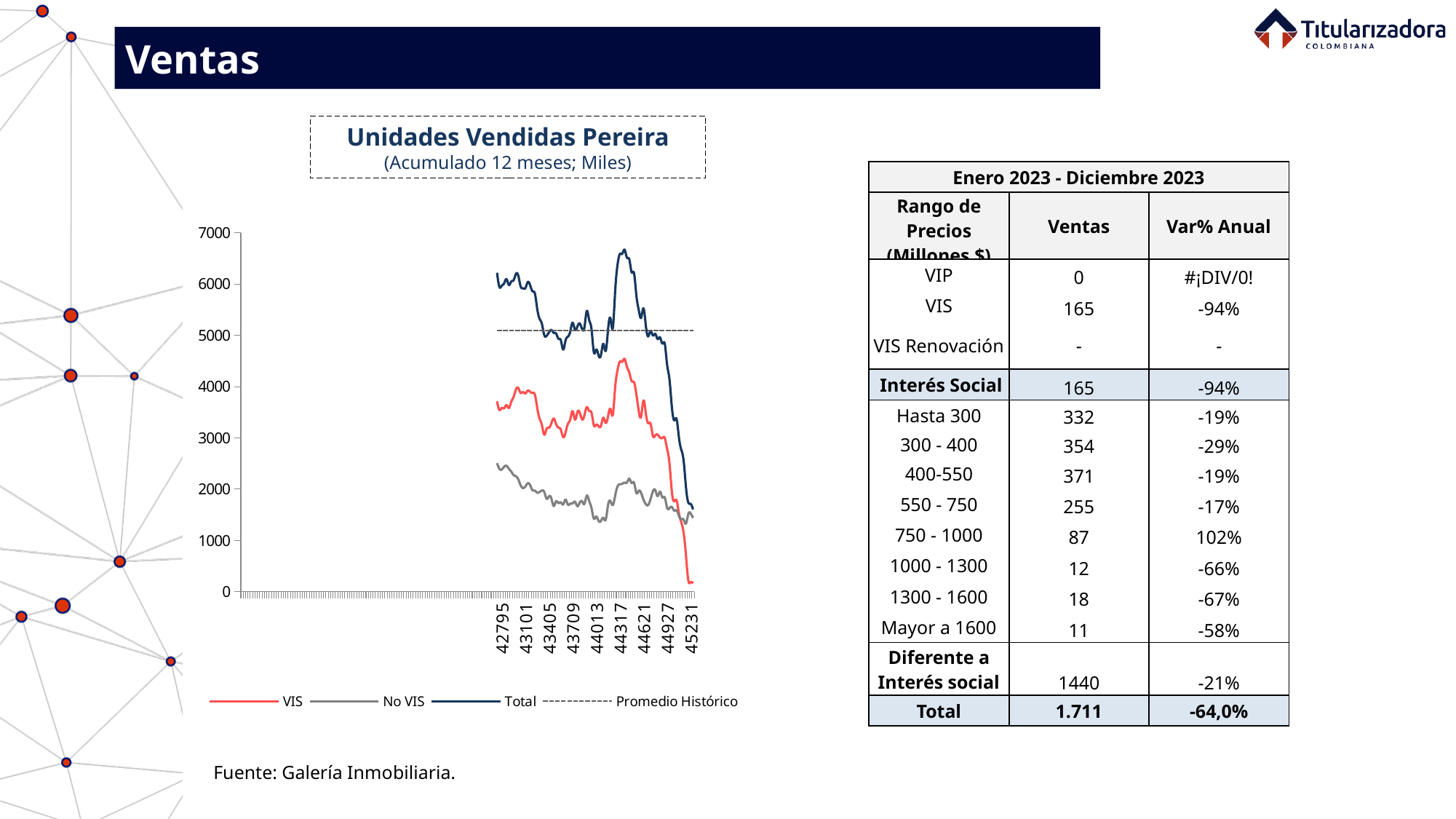
How many tick labels are shown on the x axis of the 'Unidades Vendidas Pereira' chart? 9 How many series does the legend of the 'Unidades Vendidas Pereira' chart list? 4 In the 'Unidades Vendidas Pereira' chart, is the peak value of the Total series greater or less than 6000? greater In the 'Unidades Vendidas Pereira' chart, which series reaches the highest value? Total What are the legend entries of the 'Unidades Vendidas Pereira' chart? VIS, No VIS, Total, Promedio Histórico In the 'Unidades Vendidas Pereira' chart, does the Total series overall rise or fall from the left to the right end of the x axis? fall What kind of chart is 'Unidades Vendidas Pereira'? line chart What is the subtitle shown under the title 'Unidades Vendidas Pereira'? (Acumulado 12 meses; Miles) In the 'Unidades Vendidas Pereira' chart, at the left end of the x axis, which is higher: VIS or No VIS? VIS In the 'Unidades Vendidas Pereira' chart, is the final value of the VIS series greater or less than 1000? less In the 'Unidades Vendidas Pereira' chart, which series has the lowest value at the right end of the x axis? VIS In the 'Unidades Vendidas Pereira' chart, is the first value of the No VIS series greater or less than 2000? greater